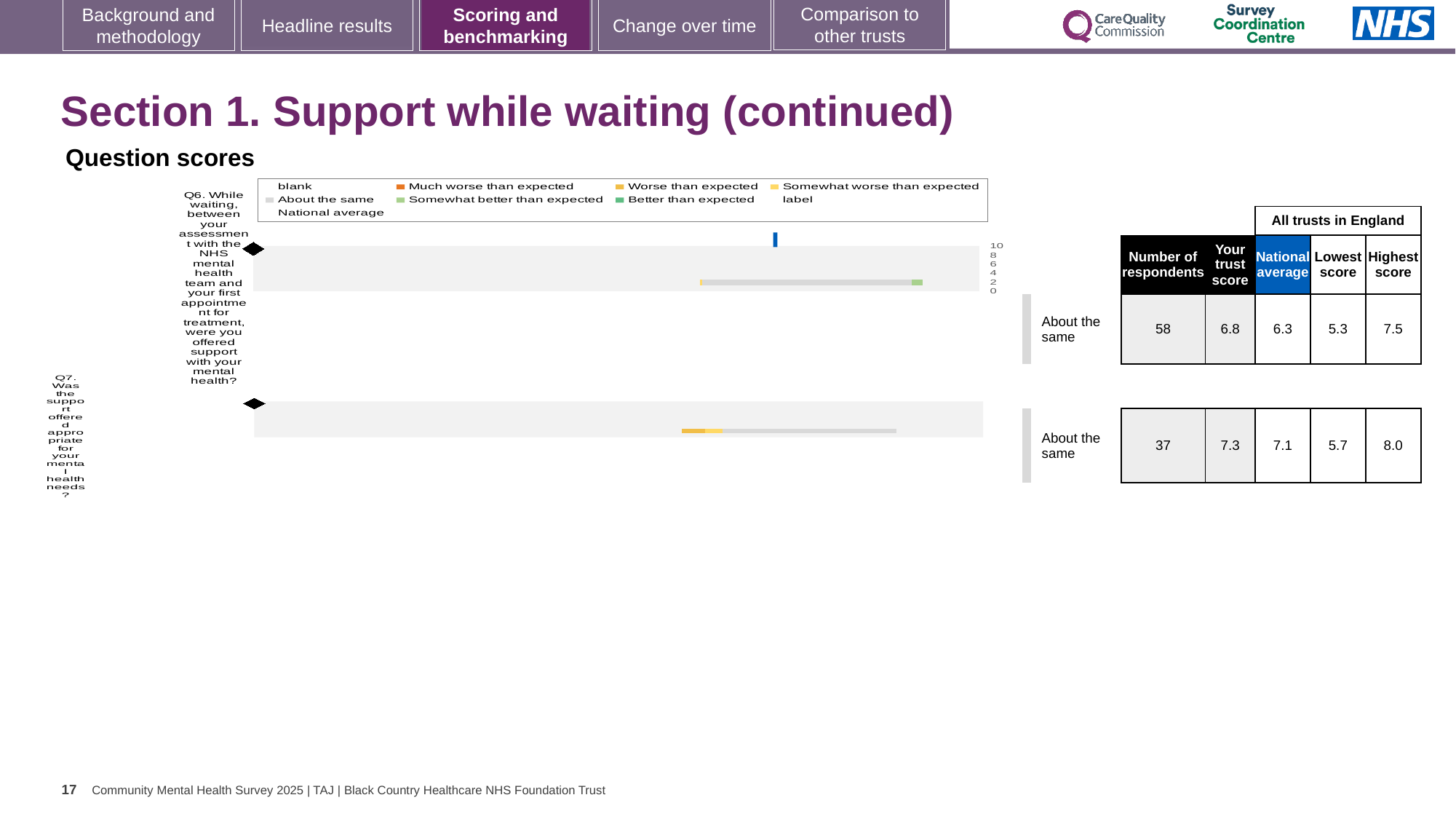
What is the trust score for Q7 (was the support offered appropriate)? 7.3 By how much does the trust score for Q6 exceed the national average? 0.5 What kind of chart is used to show the question scores? bar chart How many respondents answered Q7? 37 What benchmark category is shown for Q7? About the same For Q6, which is larger: the trust score or the national average? the trust score What is the highest score among all trusts in England for Q6? 7.5 What is the highest value shown on the chart's score axis? 10 How many questions are plotted in the question scores chart? 2 What is the difference between the highest and lowest trust scores in England for Q7? 2.3 What is the trust score for Q6 (support with mental health while waiting)? 6.8 What is the national average for Q6? 6.3